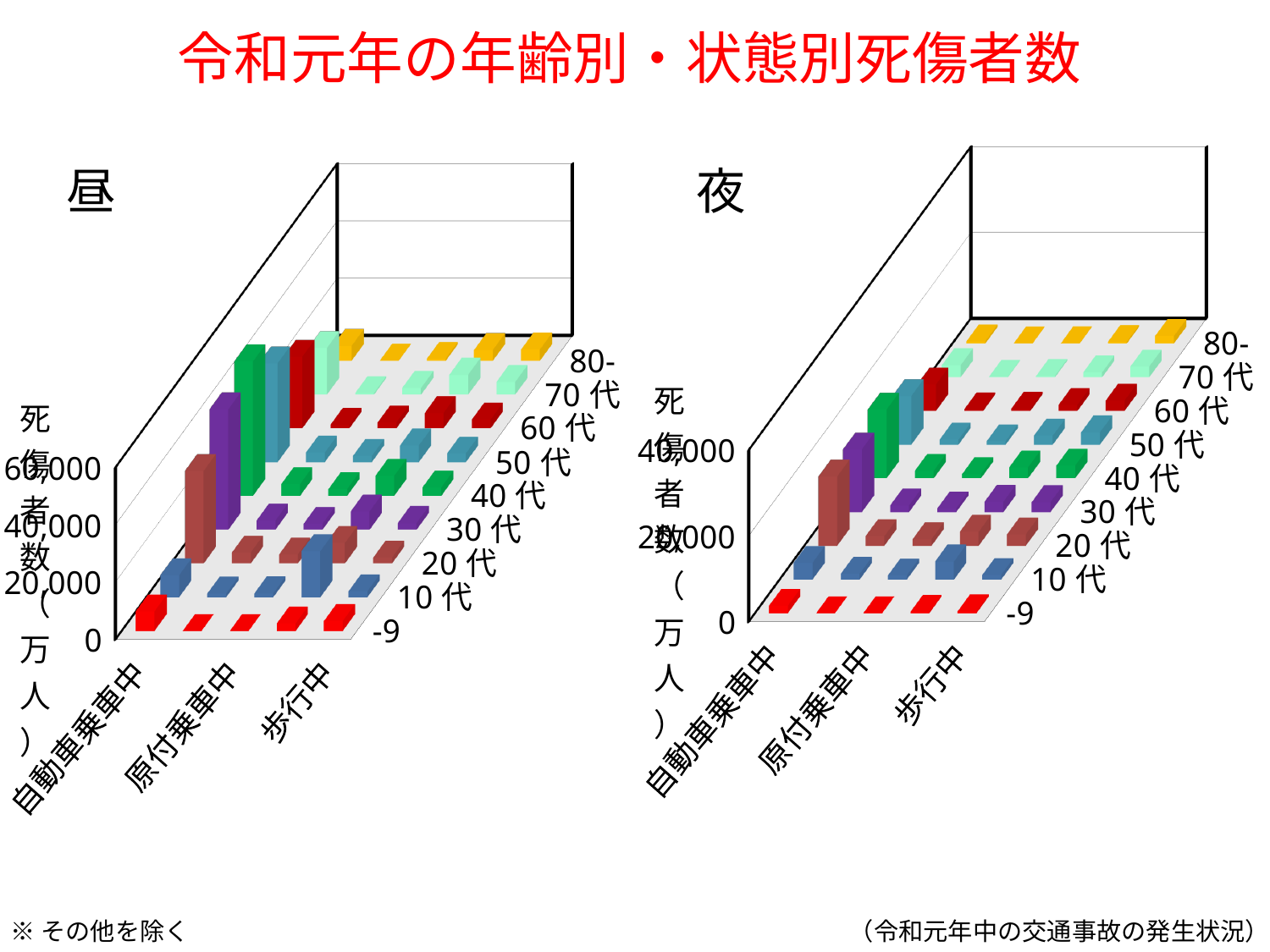
In the 夜 chart, is the value for 歩行中 in the -9 age group greater or less than 20,000? less In the 昼 chart, which category has the tallest bars overall? 自動車乗車中 What is the title of the slide? 令和元年の年齢別・状態別死傷者数 What is the highest tick value shown on the vertical axis of the 昼 chart? 60,000 What kind of chart is the 昼 chart? bar chart In the 昼 chart, for the 20代 age group, which is larger: 自動車乗車中 or 歩行中? 自動車乗車中 In the 昼 chart, is the value for 自動車乗車中 in the 20代 age group greater or less than 20,000? greater In the 夜 chart, how many age groups are plotted along the depth axis? 9 How many charts are on the slide? 2 In the 昼 chart, is the value for 自動車乗車中 in the -9 age group greater or less than 20,000? less